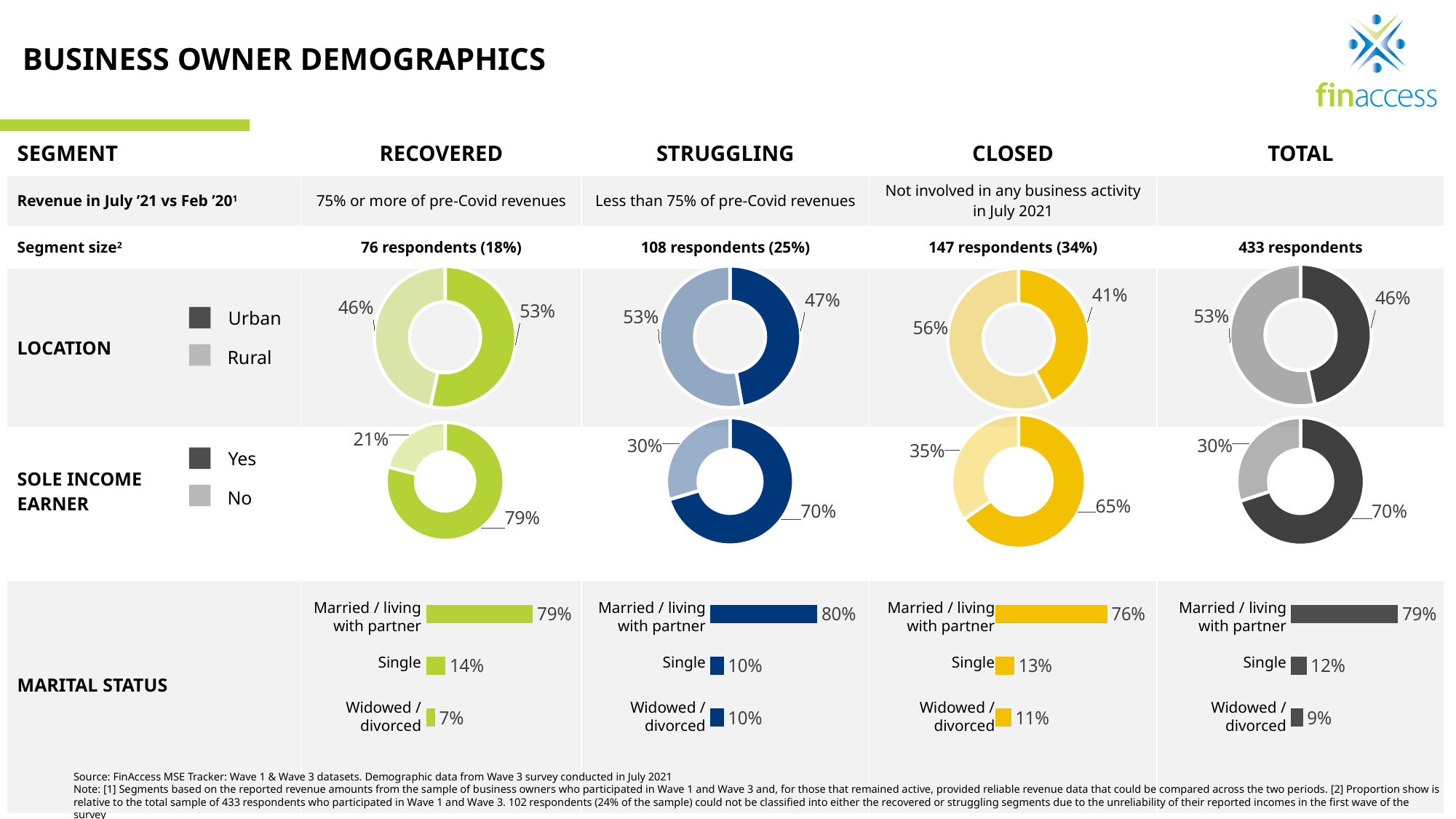
What type of chart is used to show Location for each segment? Donut chart In the Marital Status bar chart for the Total column, which category has the lowest value? Widowed / divorced In the Location donut chart for the Total column, what is the combined share of Urban and Rural? 99% In the Location donut chart for the Recovered segment, what percentage of business owners are Urban? 53% In the Marital Status bar chart for the Struggling segment, what percentage are Married / living with partner? 80% In the Sole Income Earner donut chart for the Recovered segment, what percentage answered No? 21% What type of chart is used to show Marital Status for each segment? Bar chart In the Sole Income Earner donut chart for the Struggling segment, what percentage answered Yes? 70% Comparing the Sole Income Earner donut charts, is the Yes share larger for the Recovered segment or the Closed segment? Recovered In the Location donut chart for the Closed segment, what percentage of business owners are Rural? 56% In the Marital Status bar chart for the Closed segment, what is the difference between the Married / living with partner share and the Single share? 63% How many categories are shown in the Marital Status bar chart for the Recovered segment? 3